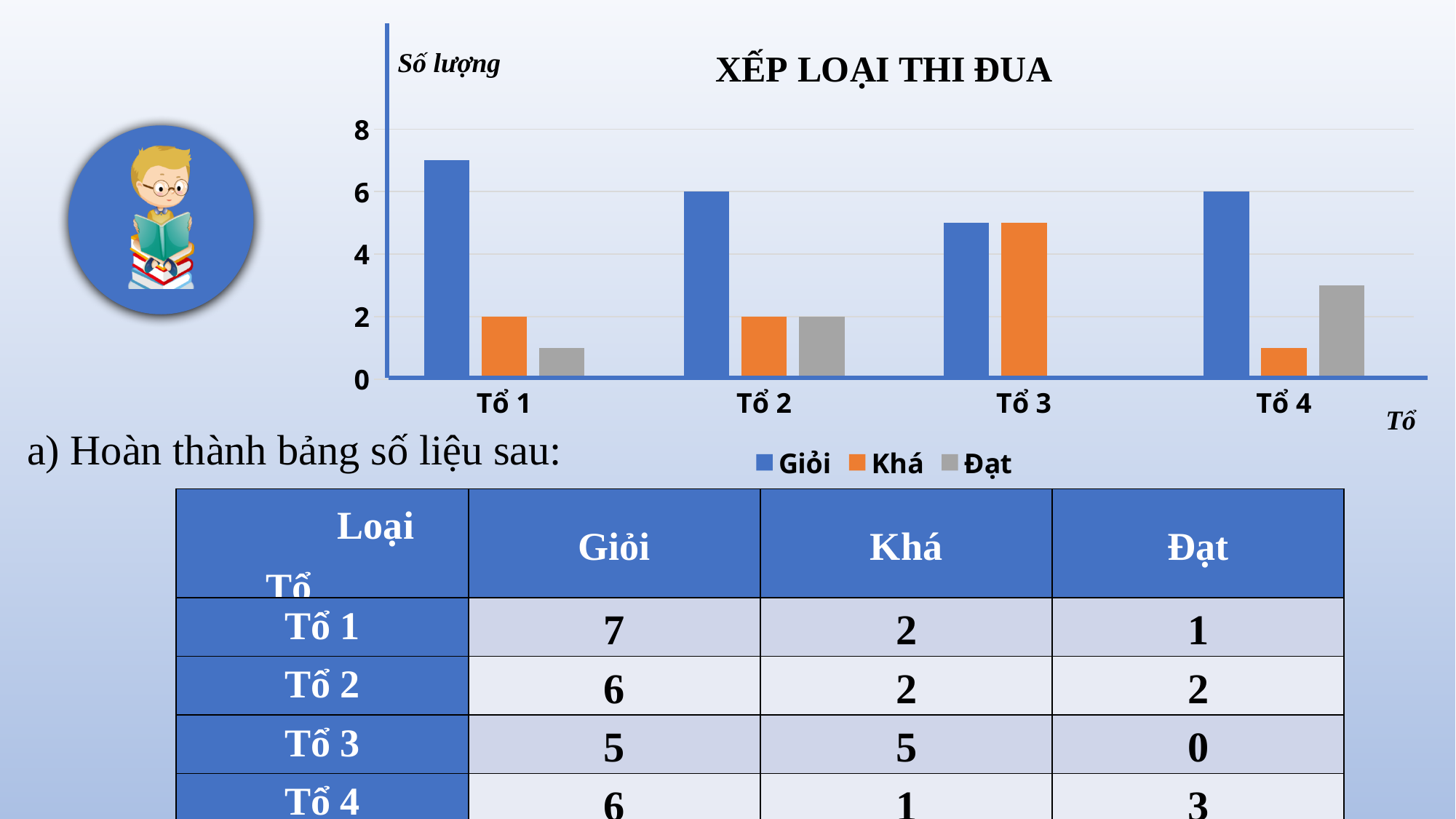
What is the Đạt value for Tổ 4? 3 What kind of chart is shown on the slide? bar chart Which is larger for Tổ 4: the Khá value or the Đạt value? Đạt What is the title of the chart? XẾP LOẠI THI ĐUA What is the Khá value for Tổ 2? 2 What is the Giỏi value for Tổ 1? 7 Which tổ has the lowest Đạt value? Tổ 3 Is the Giỏi value for Tổ 1 greater or less than 6? greater Which tổ has the highest Giỏi value? Tổ 1 How many categories (tổ) are shown on the x axis of the chart? 4 How many series does the chart legend list? 3 What is the difference between the Giỏi value for Tổ 1 and the Giỏi value for Tổ 3? 2